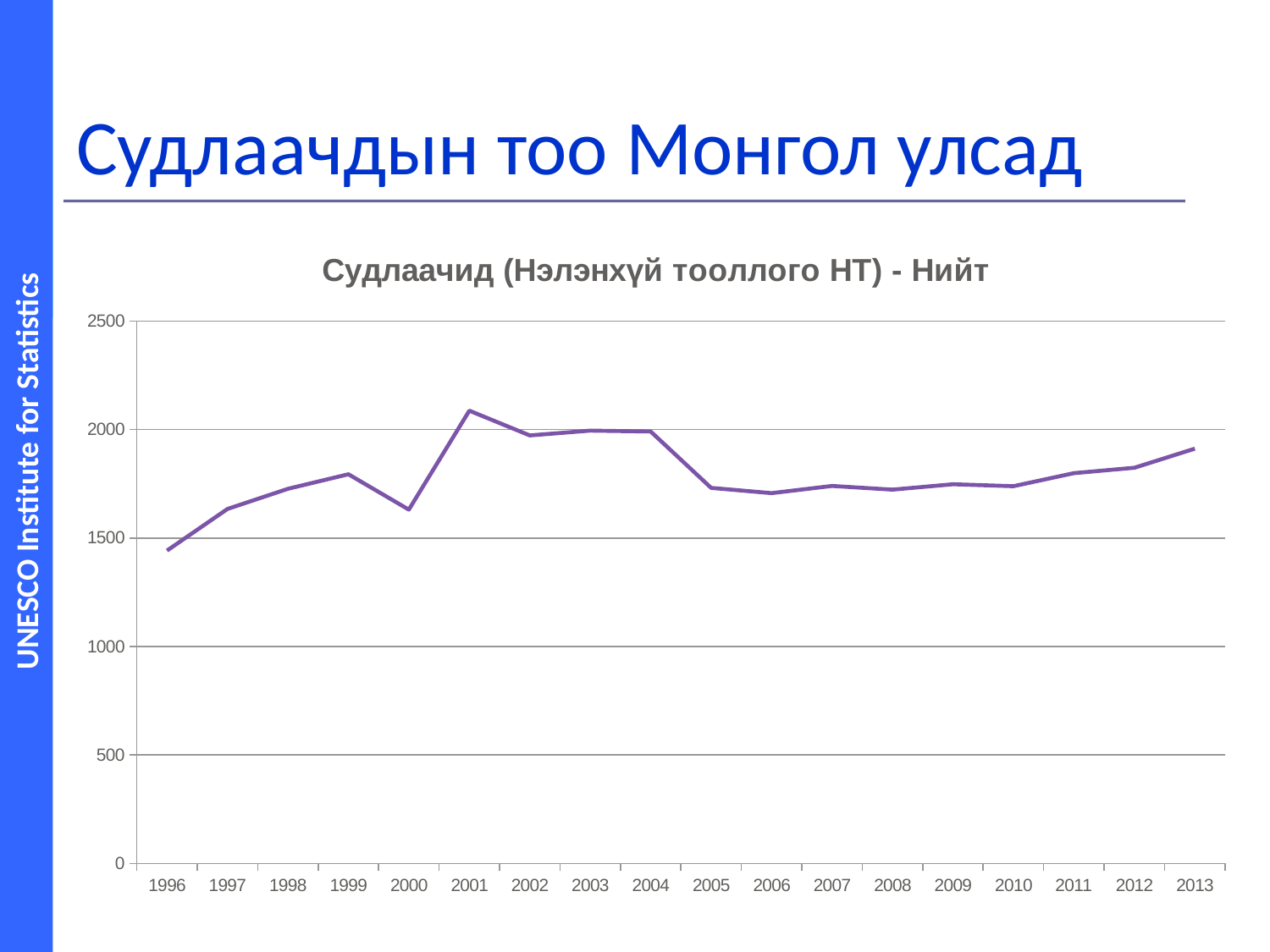
In which year does the line have its lowest value? 1996 Is the value for 2001 greater or less than 2000? greater What is the title of the chart? Судлаачид (Нэлэнхүй тооллого НТ) - Нийт Is the value for 2006 greater or less than 2000? less Is the value for 1996 greater or less than 1500? less What kind of chart is shown on the slide? line chart How many years are plotted along the x axis of the chart? 18 Which year has the larger value, 1996 or 2000? 2000 In which year does the line reach its highest value? 2001 Which year has the larger value, 2001 or 2013? 2001 Do the values rise or fall from 1996 to 1999? rise